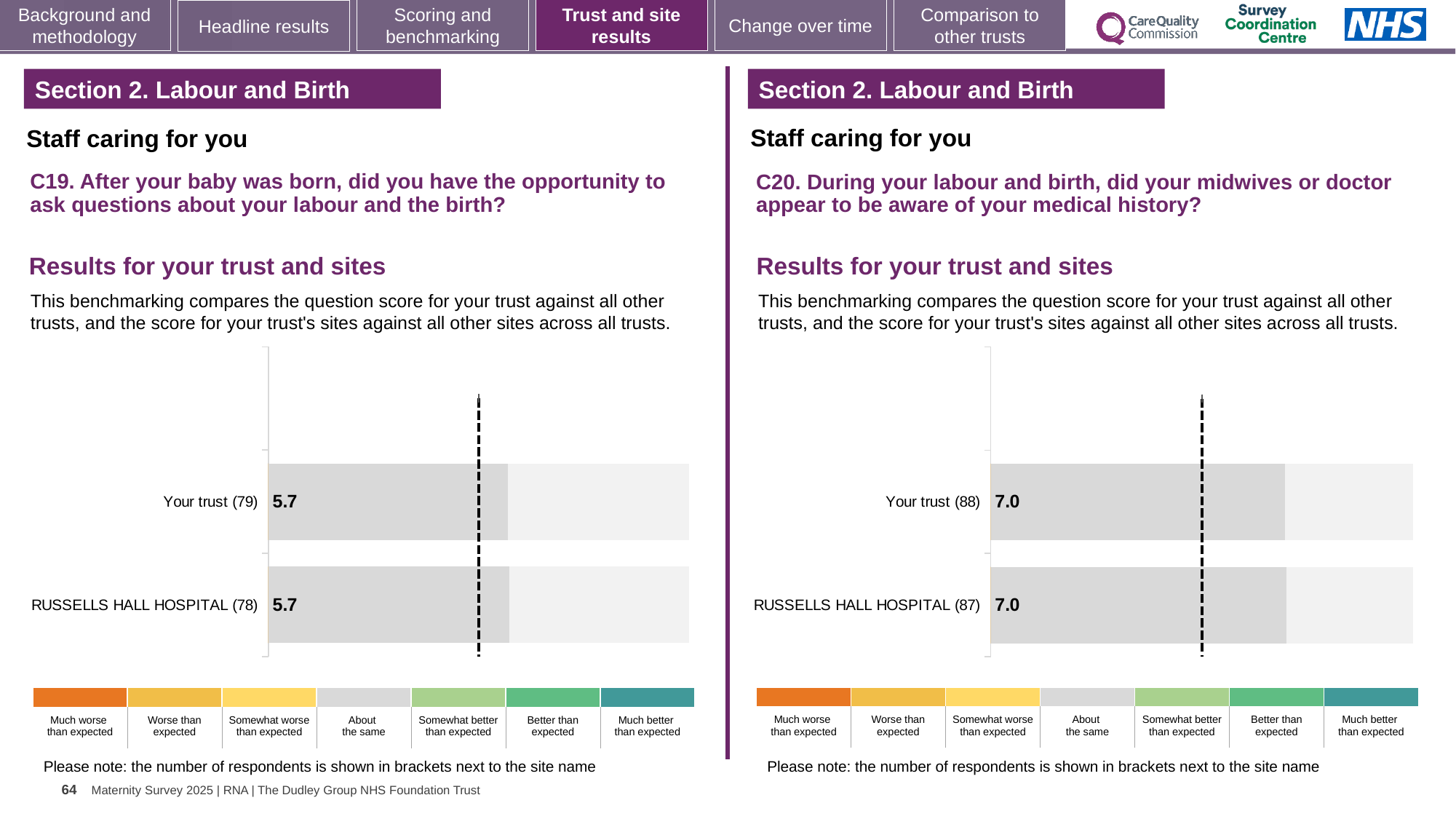
In the C19 chart on the left, what is the score for RUSSELLS HALL HOSPITAL (78)? 5.7 In the C20 chart on the right, what is the difference between the score for Your trust and the score for RUSSELLS HALL HOSPITAL? 0.0 In the C19 chart on the left, what is the score for Your trust (79)? 5.7 What kind of chart is used for the C20 results on the right? Bar chart How many bars are plotted in the C19 chart on the left? 2 In the C20 chart on the right, what is the score for Your trust (88)? 7.0 How many categories does the colour legend below the C20 chart on the right list? 7 In the C19 chart on the left, what is the difference between the score for Your trust and the score for RUSSELLS HALL HOSPITAL? 0.0 How many bars are plotted in the C20 chart on the right? 2 In the C20 chart on the right, what is the score for RUSSELLS HALL HOSPITAL (87)? 7.0 In the C19 chart on the left, how many respondents are shown in brackets for Your trust? 79